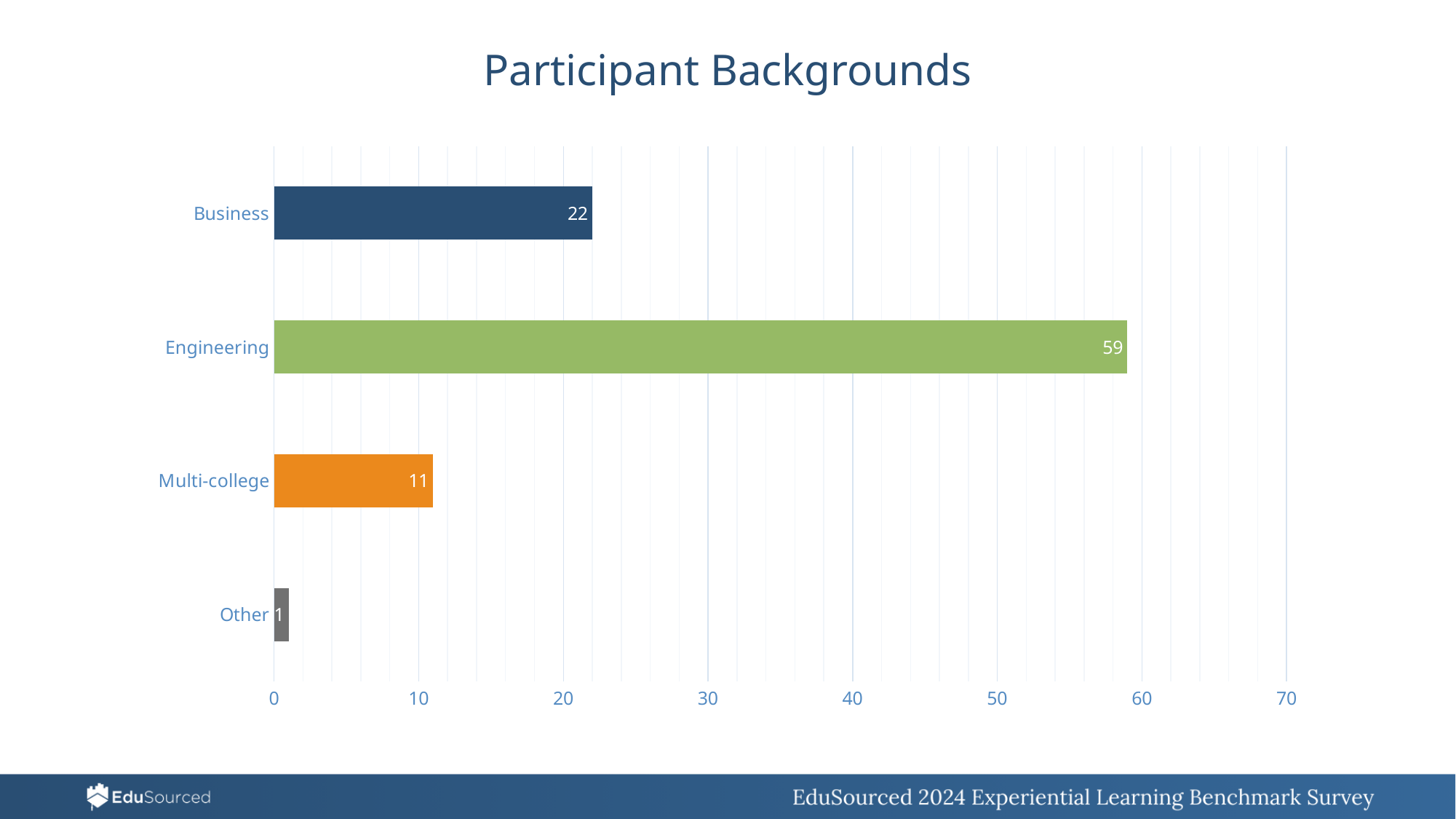
Which category has the highest value? Engineering Which category has the lowest value? Other Is the value for Engineering greater or less than 50? greater What is the title of the chart? Participant Backgrounds What is the value for Multi-college? 11 What is the value for Business? 22 What kind of chart is shown on the slide? Bar chart What is the value for Other? 1 What is the value for Engineering? 59 Which is larger, the value for Business or the value for Multi-college? Business How many categories are shown in the chart? 4 What is the difference between the values for Engineering and Business? 37